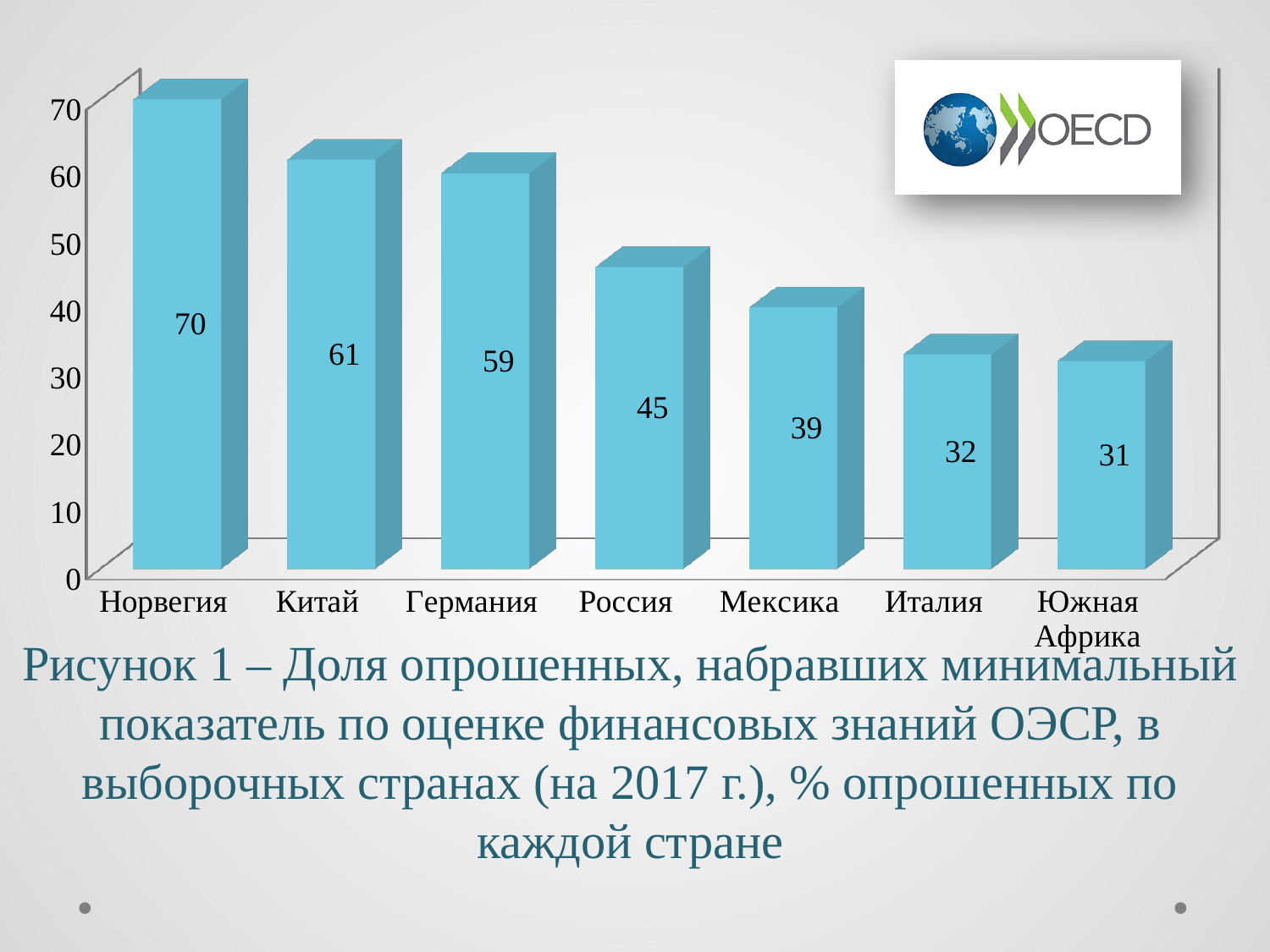
Is the value for Германия greater or less than 50? greater What kind of chart is shown on the slide? bar chart Which country has the highest value? Норвегия How many countries are shown on the chart? 7 What is the value for Норвегия? 70 What is the difference between the values for Норвегия and Россия? 25 Which is larger, the value for Мексика or the value for Италия? Мексика Do the values rise or fall from left to right along the x axis? fall What is the value for Южная Африка? 31 What is the value for Россия? 45 Which country has the lowest value? Южная Африка What is the difference between the values for Китай and Германия? 2